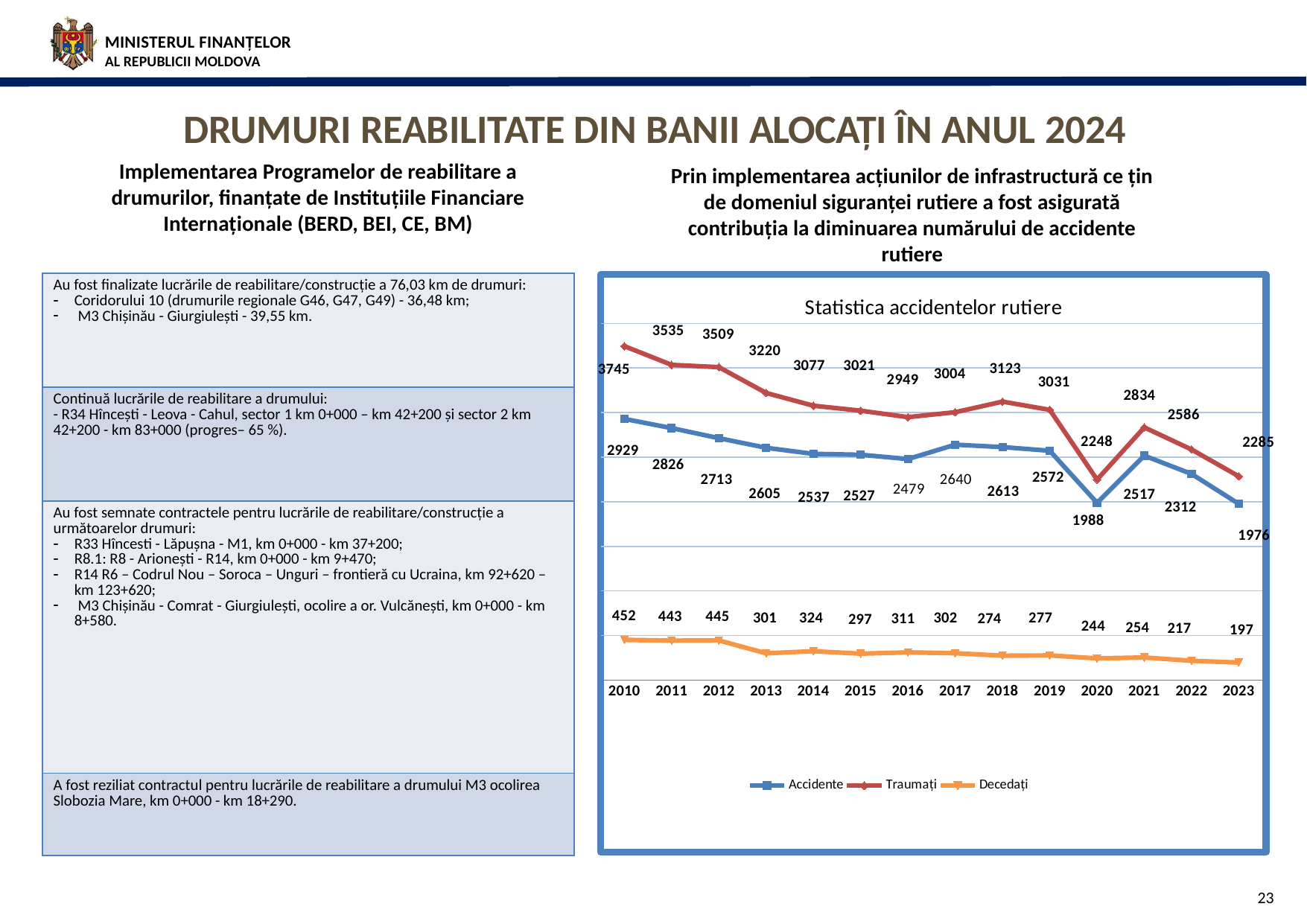
Which is larger: Accidente in 2017 or Accidente in 2016? Accidente in 2017 What is the value of Accidente in 2020? 1988 In which year is the Accidente series lowest? 2023 What is the difference between Traumați in 2021 and Traumați in 2020? 586 In which year is the Decedați series highest? 2010 How many years are shown on the x axis of "Statistica accidentelor rutiere"? 14 Overall, do the Decedați values rise or fall from 2010 to 2023? fall What type of chart is "Statistica accidentelor rutiere"? line chart Which series in "Statistica accidentelor rutiere" is drawn in orange? Decedați What is the value of Decedați in 2023? 197 How many series does the legend of "Statistica accidentelor rutiere" list? 3 What is the value of Traumați in 2010? 3745